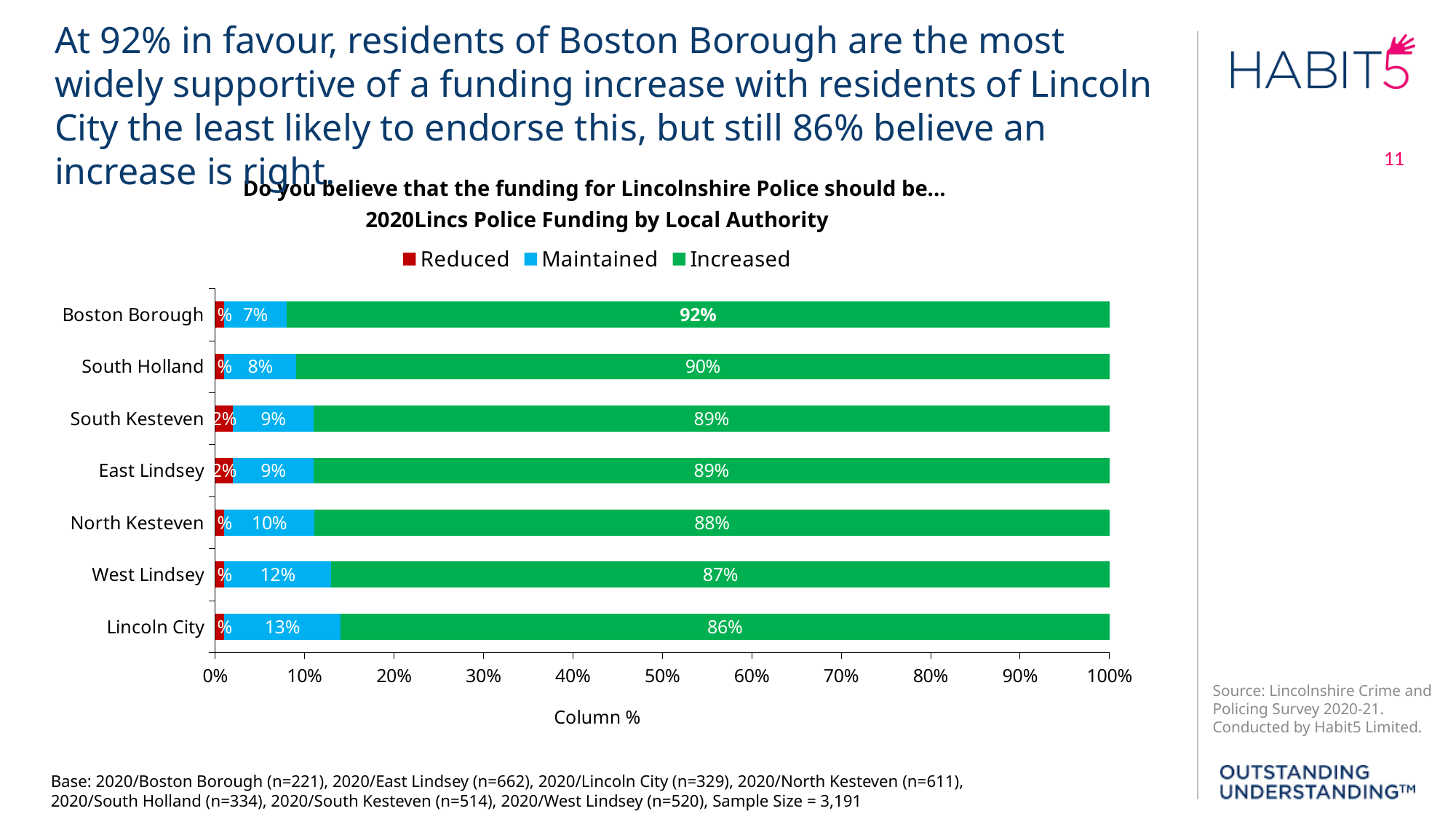
What is the Reduced value for South Kesteven? 2% How many series does the legend list? 3 How many local authorities are shown in the chart? 7 Which local authority has the lowest Increased value? Lincoln City What is the Maintained value for West Lindsey? 12% Which local authority has the highest Maintained value? Lincoln City What is the difference between the Increased values for Boston Borough and Lincoln City? 6% What percentage of Boston Borough residents said funding should be Increased? 92% Which is larger, the Maintained value for North Kesteven or for South Holland? North Kesteven What is the Maintained value for Lincoln City? 13% What type of chart is shown on the slide? Stacked bar chart Which local authority has the highest Increased value? Boston Borough